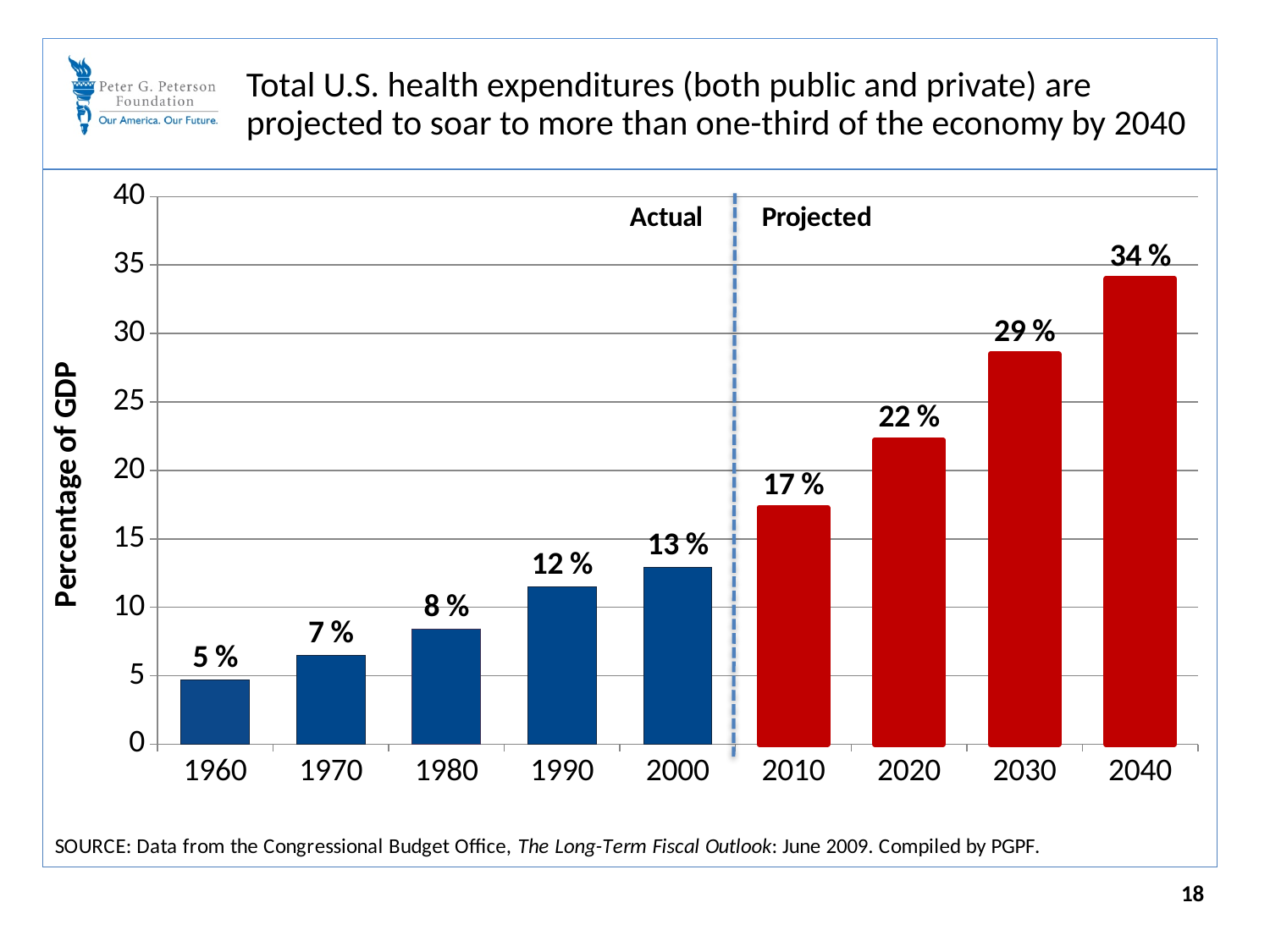
What is the difference between the values for 2040 and 2000? 21 % Which is larger, the value for 1990 or the value for 2010? 2010 How many years are shown on the x axis? 9 Which year has the lowest value? 1960 Do the values rise or fall from 1960 to 2040? rise What is the label of the y axis? Percentage of GDP What kind of chart is this? bar chart What is the value for 2030? 29 % What is the value for 2000? 13 % What is the value for 1960? 5 % Which year has the highest value? 2040 Is the value for 2020 greater or less than 20? greater